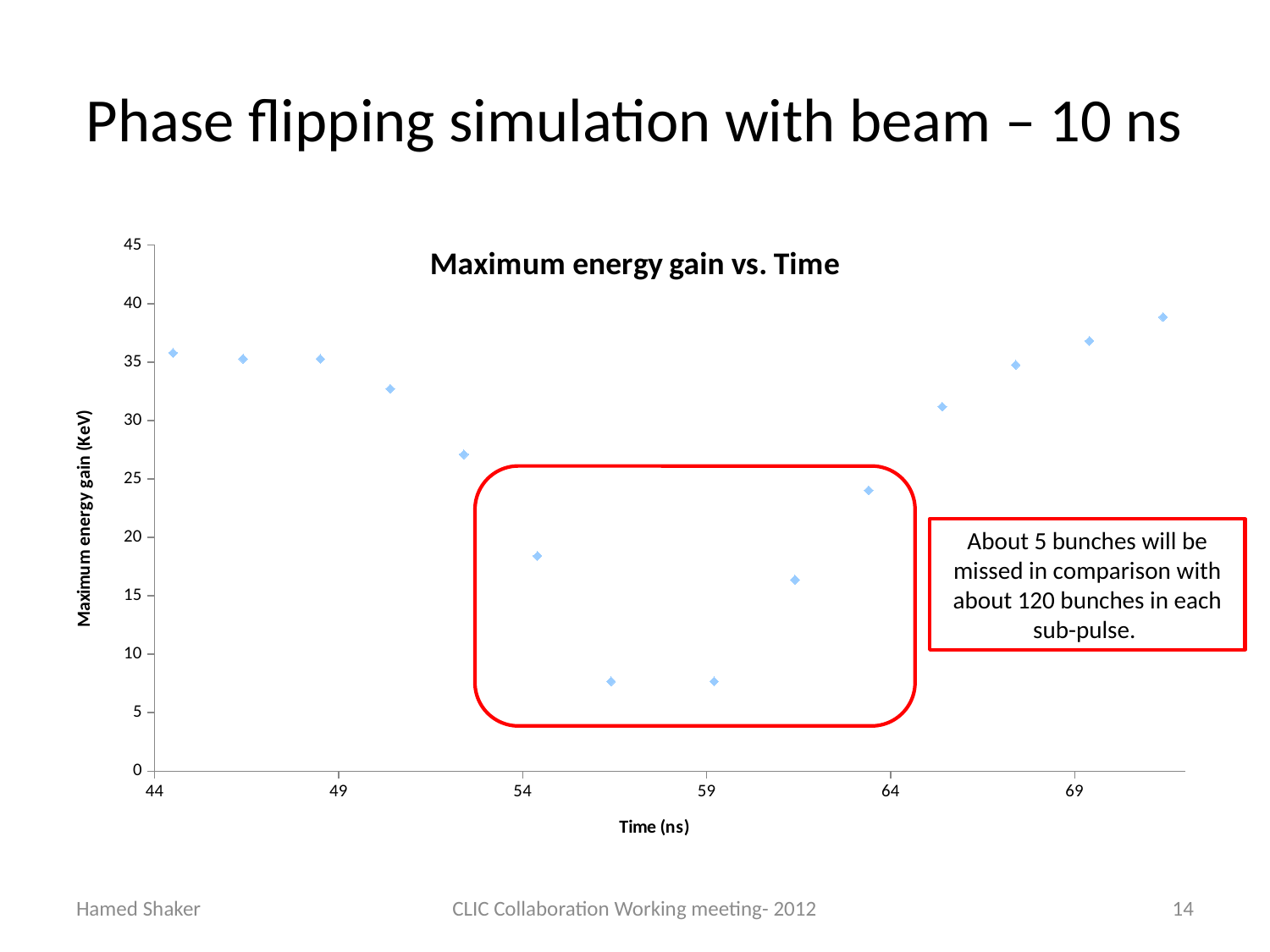
Which is larger: the value of the first point (about 44.5 ns) or the value of the last point (about 70.5 ns)? the last point (about 70.5 ns) Is the value of the point at about 50.5 ns greater or less than 30? greater Is the value of the point at about 70.5 ns greater or less than 35? greater Do the values rise or fall between about 44 ns and about 57 ns? fall What kind of chart is shown on the slide? scatter plot Is the value of the point at about 56.5 ns greater or less than 10? less How many data points are plotted on the chart? 14 How many data points lie inside the red rounded box? 5 What is the label of the y axis? Maximum energy gain (KeV) What is the title of the chart? Maximum energy gain vs. Time